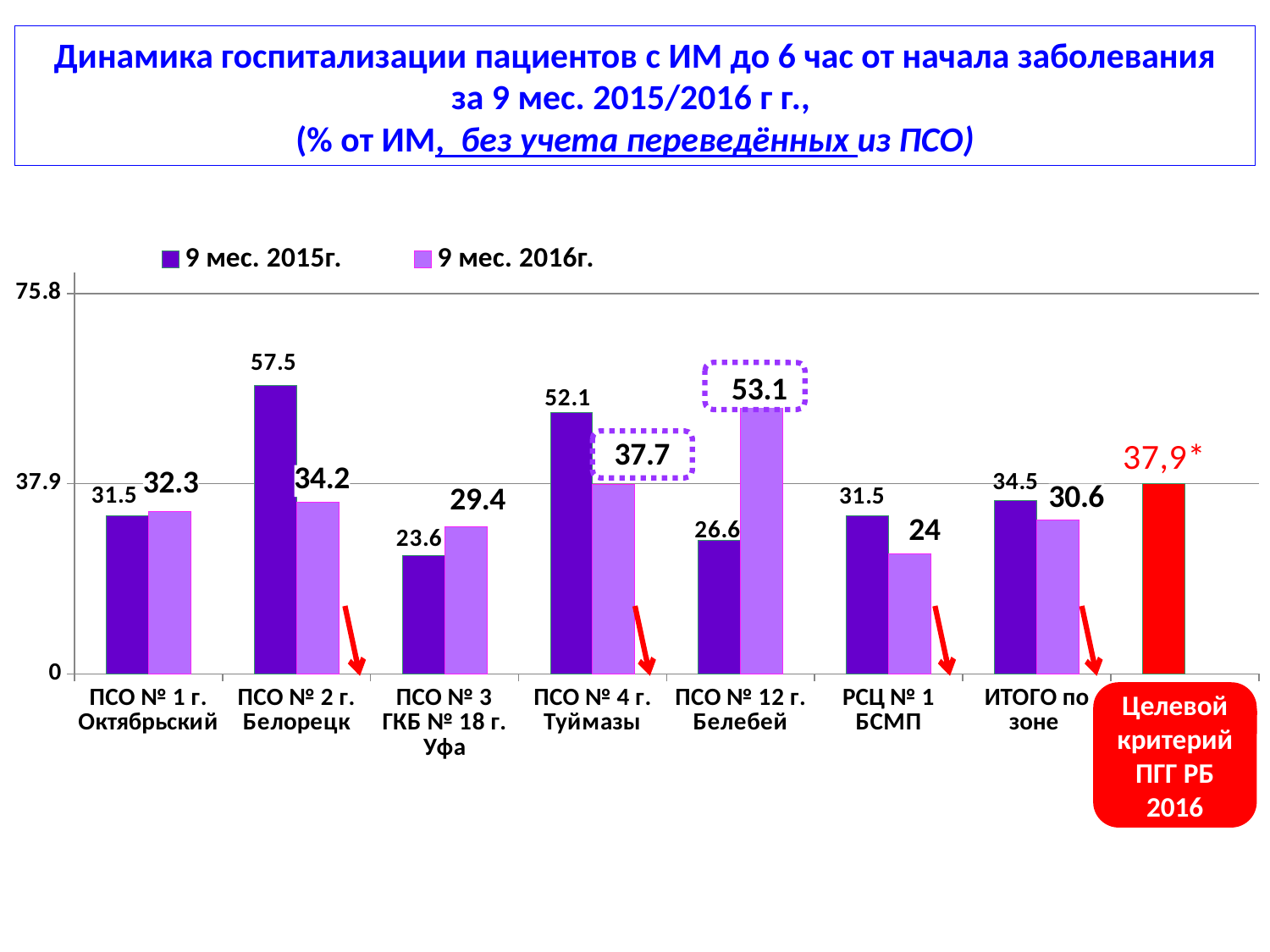
What colour are the bars for the 9 мес. 2015г. series? dark purple Which category has the highest value for 9 мес. 2015г.? ПСО № 2 г. Белорецк Is the 9 мес. 2016г. value for ПСО № 12 г. Белебей greater or less than 37.9? greater What is the difference between the 9 мес. 2015г. and 9 мес. 2016г. values for ПСО № 4 г. Туймазы? 14.4 What type of chart is shown on the slide? bar chart What is the value for ИТОГО по зоне for 9 мес. 2016г.? 30.6 What is the value for ПСО № 2 г. Белорецк for 9 мес. 2015г.? 57.5 Which category has the lowest value for 9 мес. 2016г.? РСЦ № 1 БСМП For ПСО № 3 ГКБ № 18 г. Уфа, which is larger: the 9 мес. 2015г. value or the 9 мес. 2016г. value? 9 мес. 2016г. How many series does the legend list? 2 What is the value shown for the red bar labelled Целевой критерий ПГГ РБ 2016? 37,9* What is the value for ПСО № 12 г. Белебей for 9 мес. 2016г.? 53.1